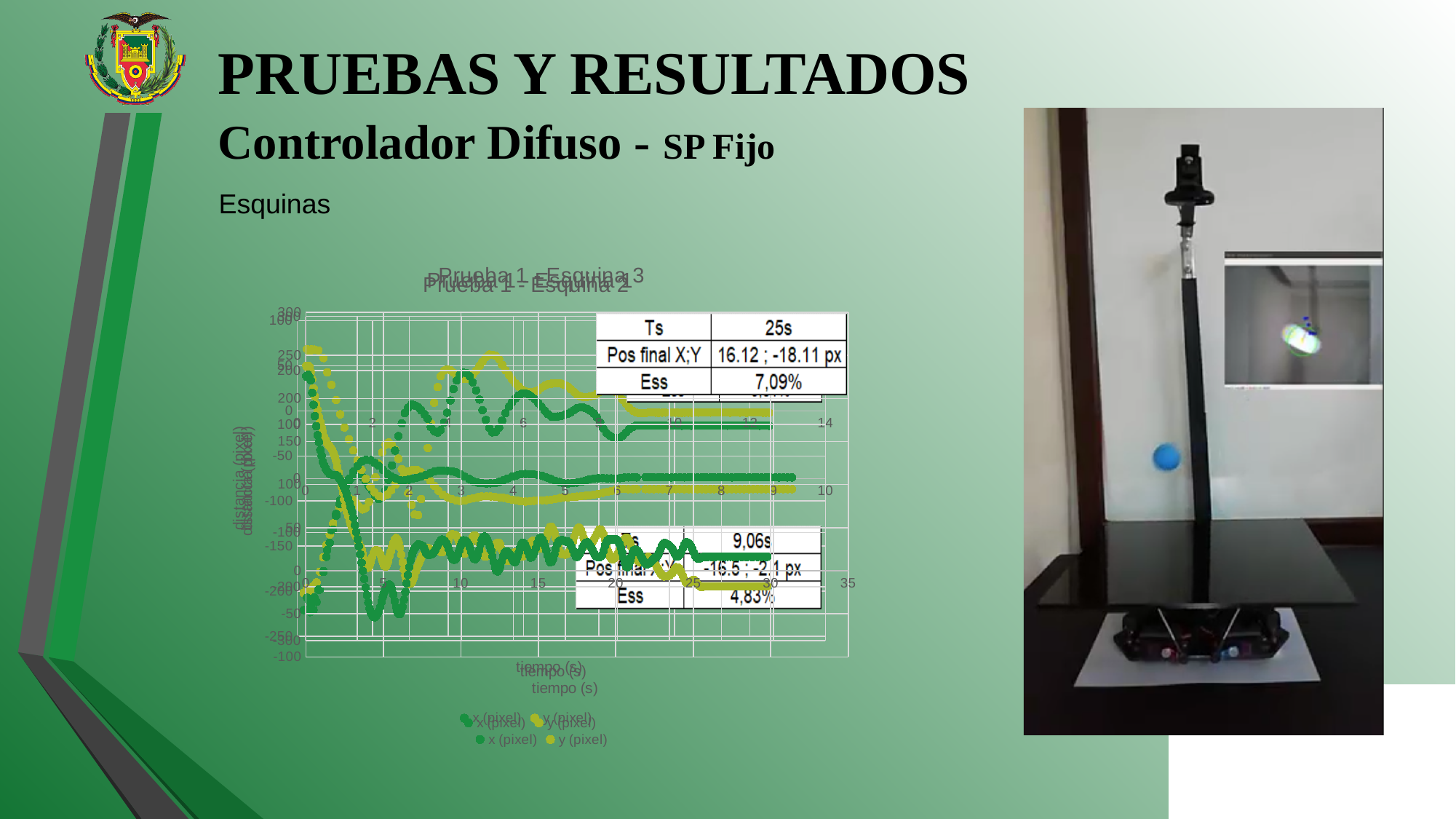
How many series does the chart legend list? 2 In the lower results table on the chart, what is the value of Ts? 9,06s In the upper results table on the chart, what is the value of Ts? 25s What is the label of the x axis of the chart? tiempo (s) What are the two series named in the chart legend? x (pixel) and y (pixel) In the upper results table on the chart, what is the Pos final X;Y? 16.12 ; -18.11 px Which results table on the chart shows the larger Ess value, the upper or the lower one? the upper one What kind of chart is shown on the slide? scatter chart In the lower results table on the chart, what is the Pos final X;Y? -16.5 ; -2.1 px In the lower results table on the chart, what is the value of Ess? 4,83% In the upper results table on the chart, what is the value of Ess? 7,09%